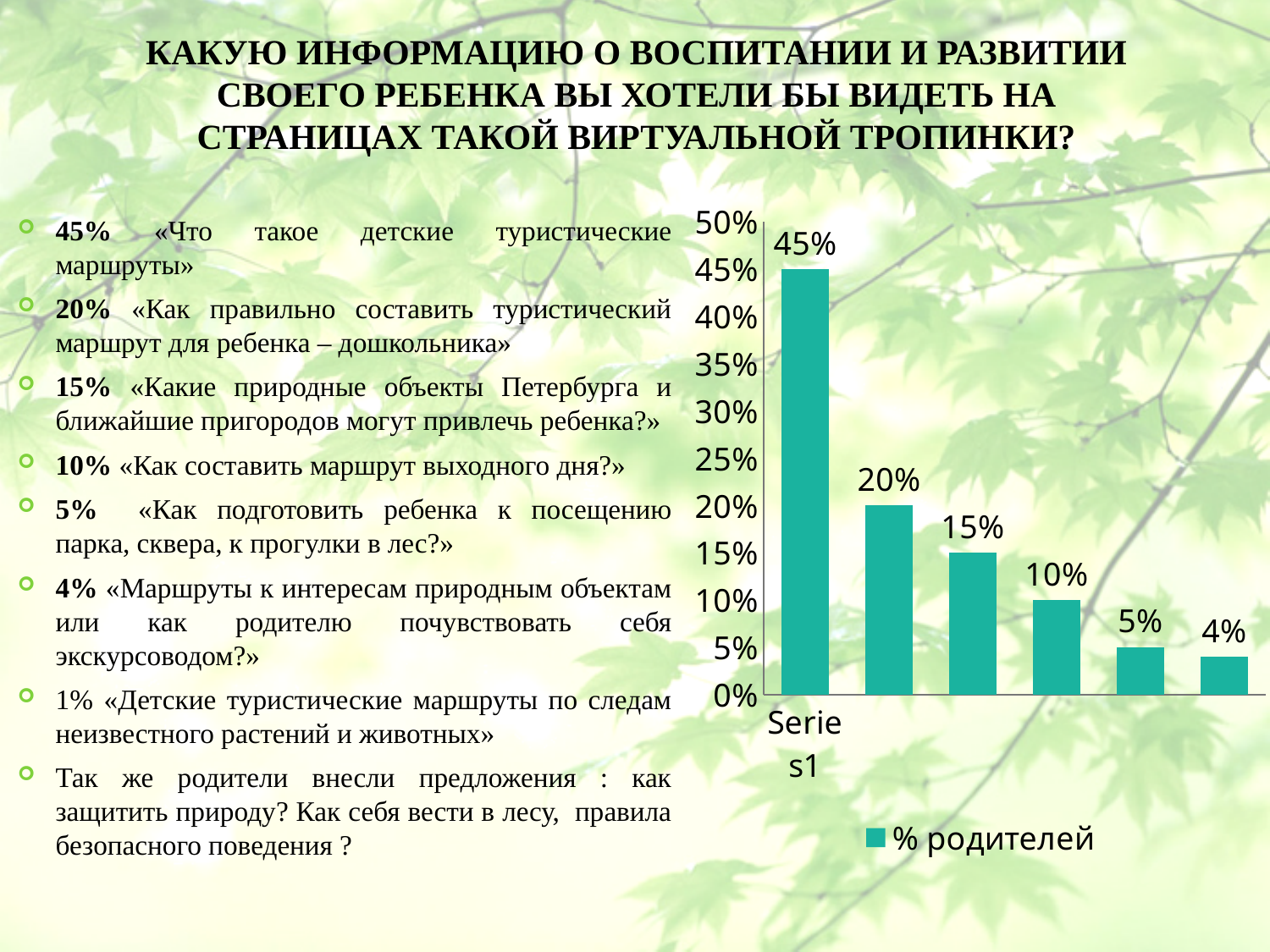
What is the difference between the first bar (45%) and the second bar (20%)? 25% What is the highest value shown in the chart? 45% What is the lowest value shown in the chart? 4% What is the name of the series shown in the chart legend? % родителей What is the value of the first (tallest) bar in the chart? 45% Which is larger, the third bar or the fourth bar? the third bar (15%) What is the value of the second bar in the chart? 20% Do the bar values rise or fall from left to right across the chart? fall How many series does the chart legend list? 1 How many bars are plotted in the chart? 6 What is the value of the last bar in the chart? 4% What type of chart is shown on the slide? bar chart